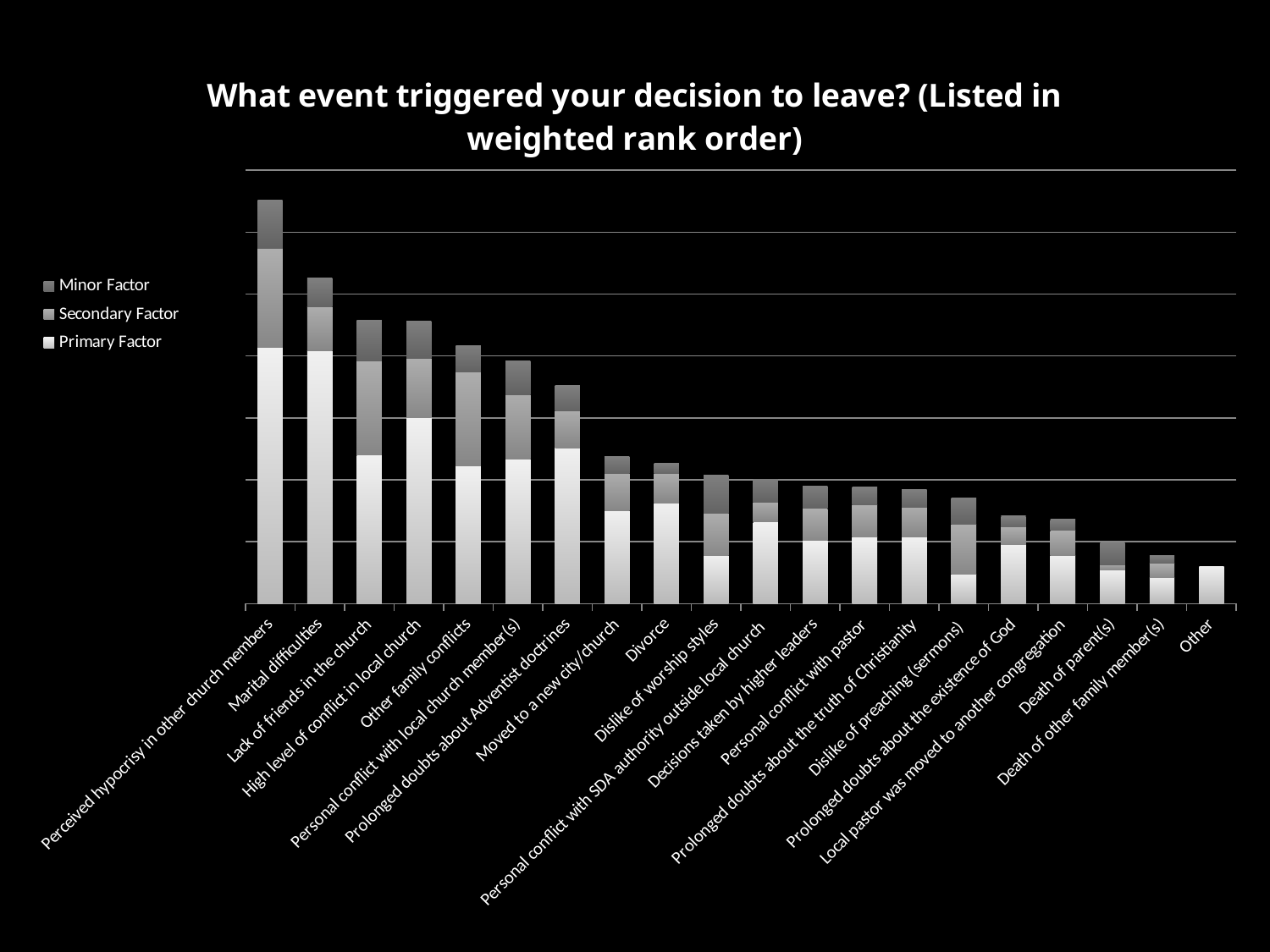
Which category has the shortest stacked bar overall? Other What is the title of the chart? What event triggered your decision to leave? (Listed in weighted rank order) Which has the taller stacked bar, Marital difficulties or Divorce? Marital difficulties Which has the taller stacked bar, Lack of friends in the church or Death of parent(s)? Lack of friends in the church Do the stacked bar totals generally rise or fall from left to right along the x axis? Fall Which has the larger Primary Factor segment, Perceived hypocrisy in other church members or Dislike of worship styles? Perceived hypocrisy in other church members What kind of chart is shown on the slide? Stacked bar chart How many series does the legend list? 3 Which series is listed first in the legend? Minor Factor How many categories are shown along the x axis? 20 Which category has the tallest stacked bar overall? Perceived hypocrisy in other church members